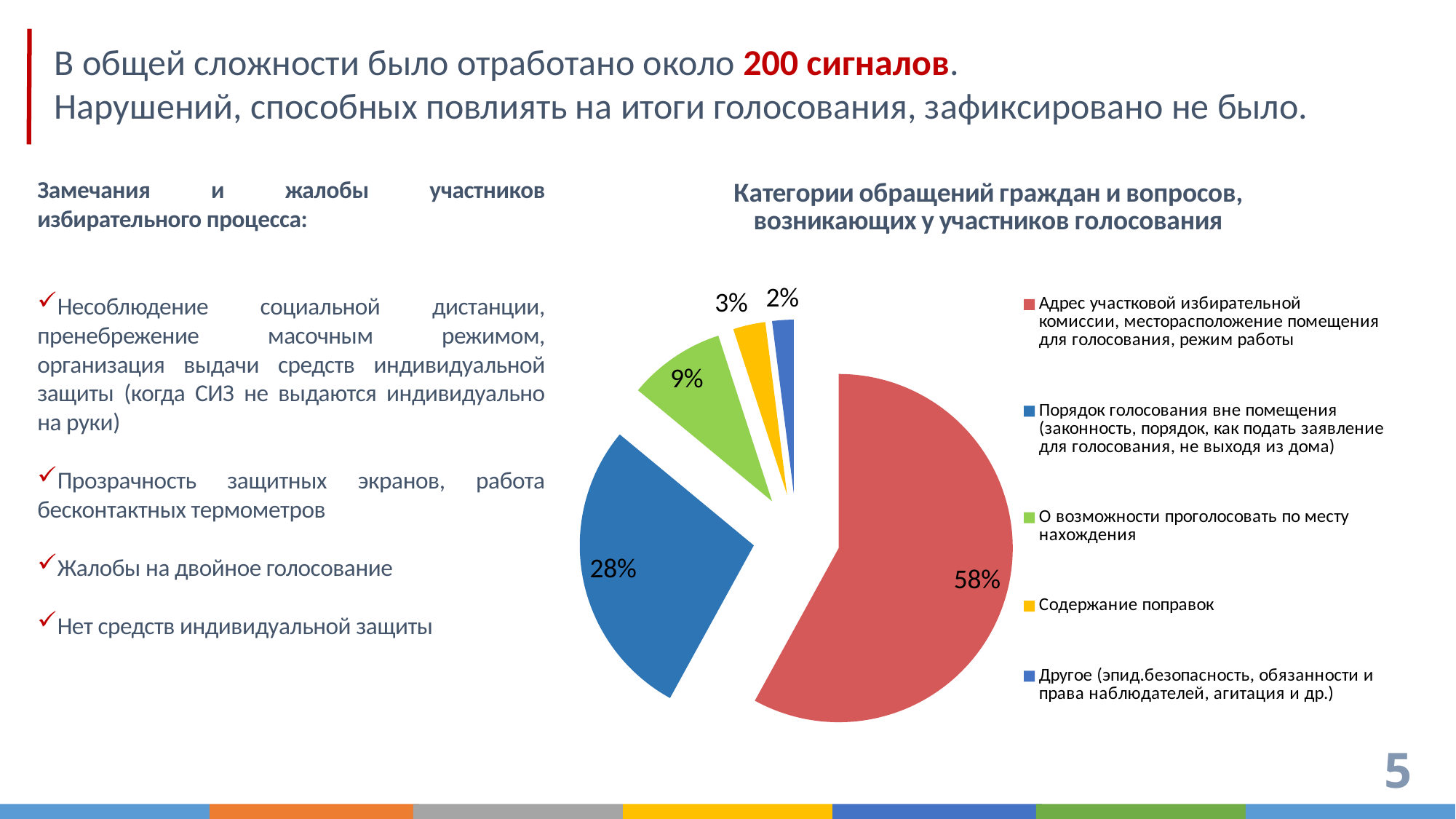
Which category has the largest slice in the pie chart? Адрес участковой избирательной комиссии, месторасположение помещения для голосования, режим работы What share of the pie does the slice "Адрес участковой избирательной комиссии, месторасположение помещения для голосования, режим работы" represent? 58% What share of the pie does the slice "Другое (эпид.безопасность, обязанности и права наблюдателей, агитация и др.)" represent? 2% What is the title of the pie chart? Категории обращений граждан и вопросов, возникающих у участников голосования How many slices does the pie chart have? 5 What share of the pie does the slice "Порядок голосования вне помещения" represent? 28% How many entries does the legend of the pie chart list? 5 What is the difference in percentage points between the "Адрес участковой избирательной комиссии" slice and the "Порядок голосования вне помещения" slice? 30% Which category has the smallest slice in the pie chart? Другое (эпид.безопасность, обязанности и права наблюдателей, агитация и др.) What kind of chart is shown on the slide? pie chart